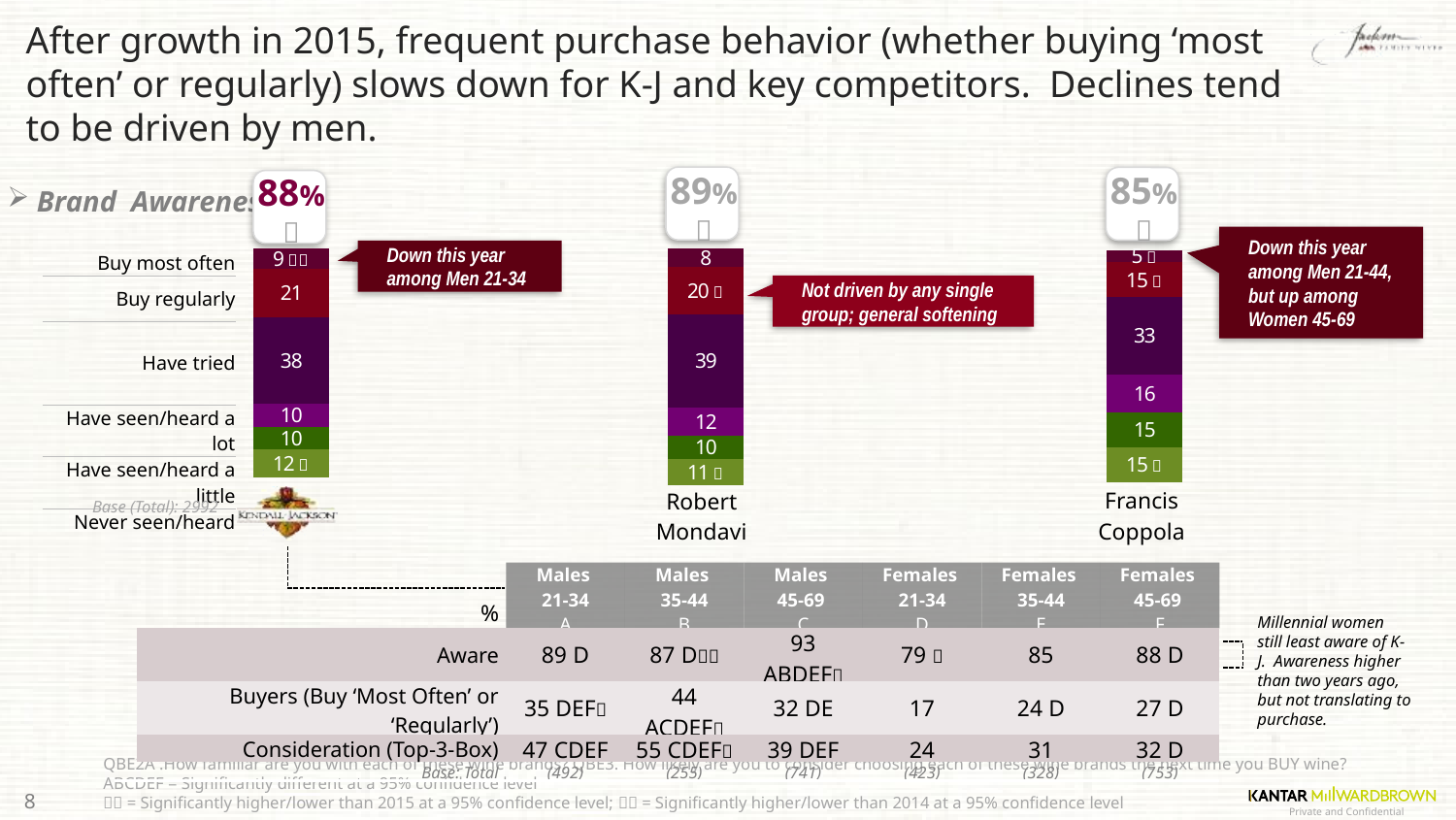
Which brand has the larger 'Buy regularly' value, Robert Mondavi or Francis Coppola? Robert Mondavi In the left (Kendall-Jackson) stacked bar, what value is shown for 'Buy most often'? 9 Which of the three brands has the highest awareness percentage shown above its bar? Robert Mondavi (89%) In the Francis Coppola stacked bar, what value is shown for 'Have seen/heard a lot'? 16 In the Francis Coppola stacked bar, what value is shown for 'Buy regularly'? 15 What is the difference between the 'Have tried' value in the left (Kendall-Jackson) bar and the 'Have tried' value in the Francis Coppola bar? 5 What awareness percentage is displayed above the Robert Mondavi bar? 89% What kind of chart is used to show the brand awareness breakdown for each brand? Stacked bar chart Which of the three brands has the lowest awareness percentage shown above its bar? Francis Coppola (85%) In the Robert Mondavi stacked bar, what percentage is shown for 'Have tried'? 39 What is the total of all segments in the left (Kendall-Jackson) stacked bar? 100 How many segments (categories) make up each brand's stacked bar? 6